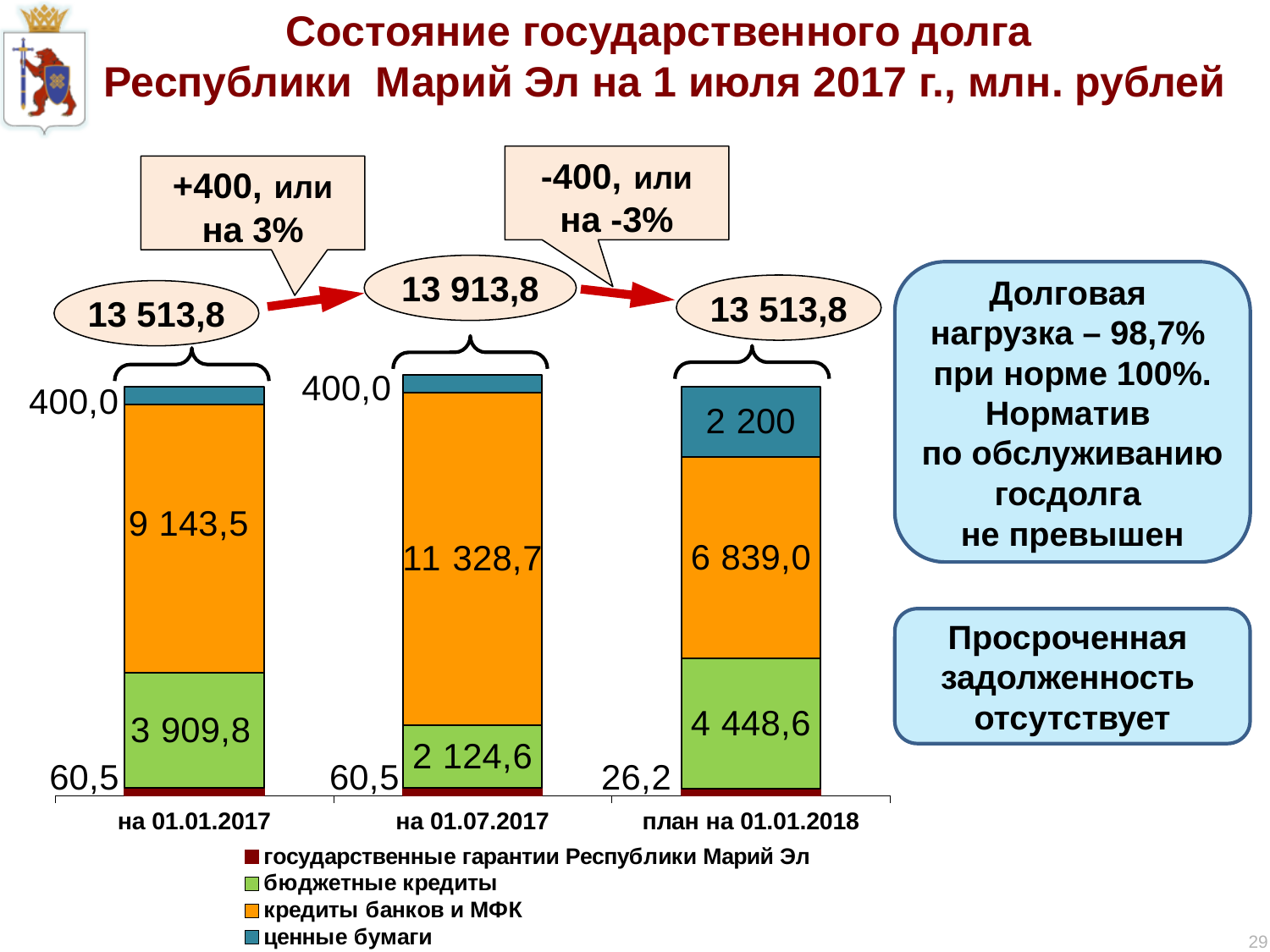
What is the difference between кредиты банков и МФК for на 01.07.2017 and for на 01.01.2017? 2 185,2 What is the total of the stacked bar for на 01.07.2017? 13 913,8 What is the value of кредиты банков и МФК for на 01.07.2017? 11 328,7 Which date has the lowest value for бюджетные кредиты? на 01.07.2017 What is the value of ценные бумаги for план на 01.01.2018? 2 200 How many series does the legend list? 4 What kind of chart is shown on the slide? stacked bar chart How many dates (categories) are shown on the x axis? 3 Which date has the highest value for кредиты банков и МФК? на 01.07.2017 Which is larger: бюджетные кредиты for на 01.01.2017 or for план на 01.01.2018? план на 01.01.2018 What is the value of бюджетные кредиты for план на 01.01.2018? 4 448,6 What is the value of государственные гарантии Республики Марий Эл for на 01.01.2017? 60,5